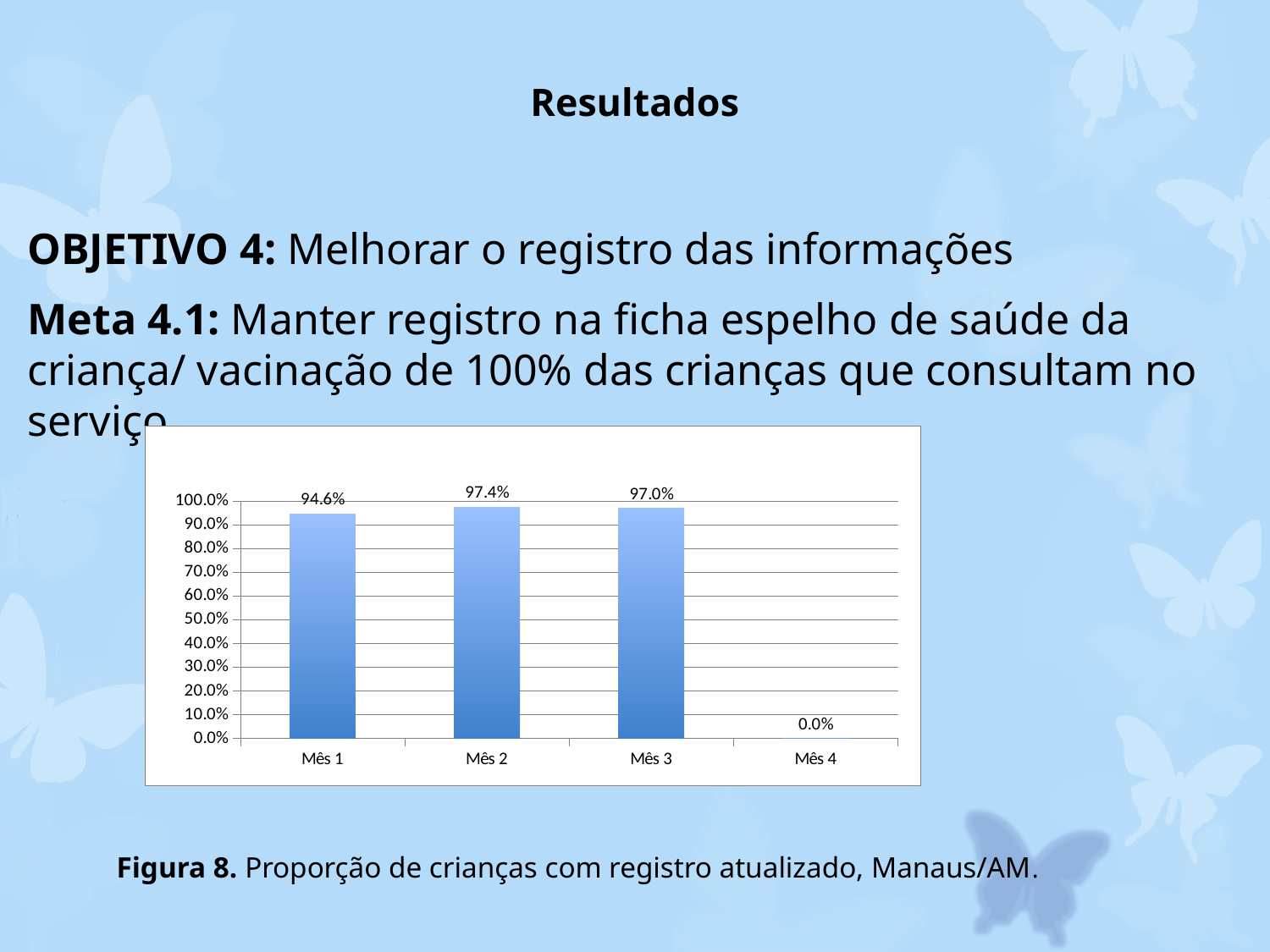
How many months are shown on the x axis? 4 What is the value for Mês 4? 0.0% What is the value for Mês 2? 97.4% What is the value for Mês 3? 97.0% What kind of chart is shown on the slide? bar chart Which month has the highest value? Mês 2 Which month has the lowest value? Mês 4 Which is larger, the value for Mês 1 or the value for Mês 3? Mês 3 What is the difference between the values for Mês 2 and Mês 1? 2.8% What is the figure caption below the chart? Figura 8. Proporção de crianças com registro atualizado, Manaus/AM. Is the value for Mês 1 greater or less than 90.0%? greater What is the value for Mês 1? 94.6%